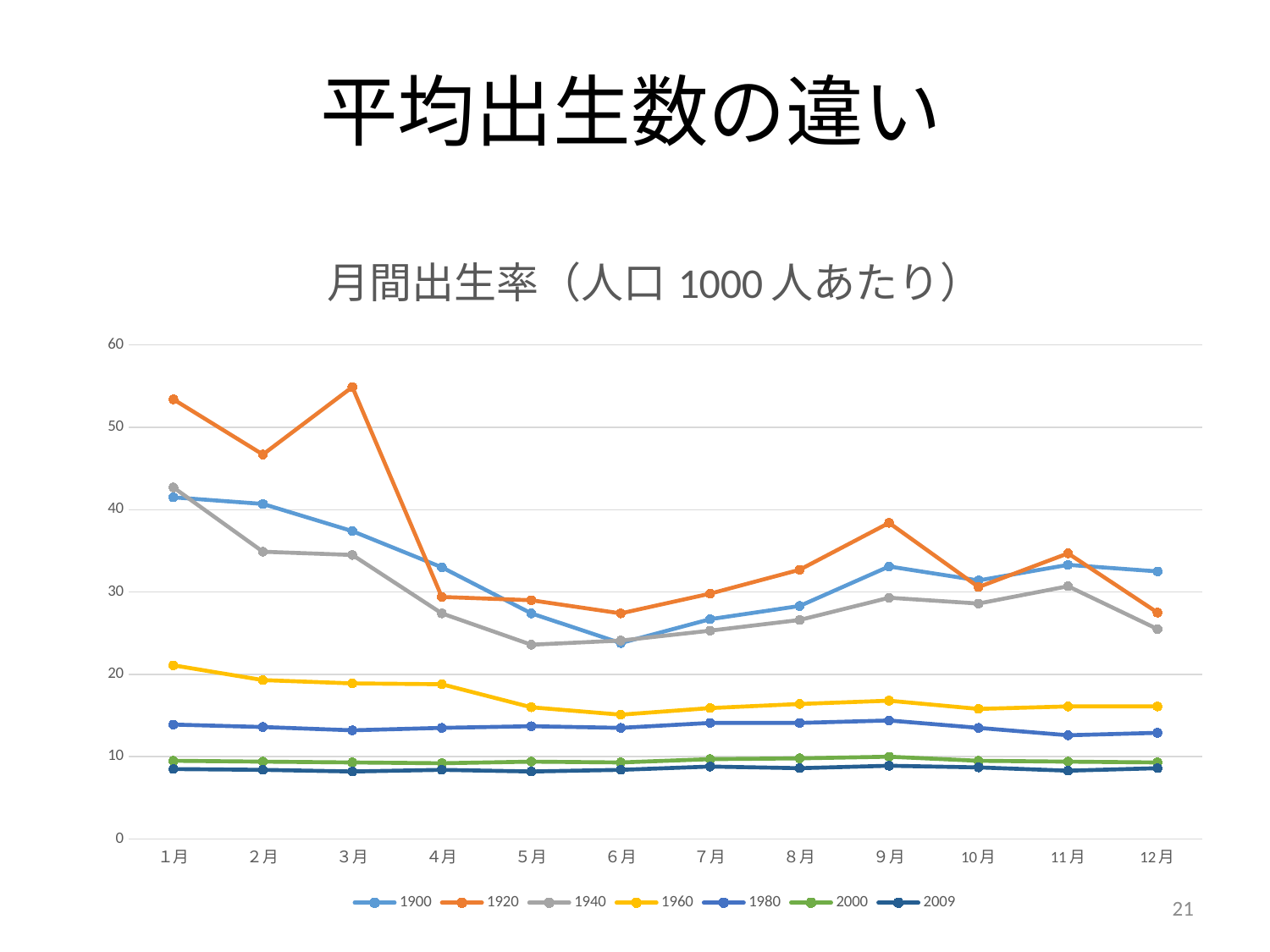
Does the 1960 series rise or fall from 1月 to 6月? fall Which series has the lowest value in 1月? 2009 In 6月, which is larger, the value for 1920 or the value for 1900? 1920 In which month does the 1920 series reach its highest value? 3月 Is the value for 1980 in 9月 greater or less than 10? greater Is the value for 1960 in 6月 greater or less than 20? less What kind of chart is shown on the slide? line chart How many series does the legend list? 7 How many months are plotted along the x axis? 12 Is the value for 1920 in 3月 greater or less than 50? greater What is the title of the chart? 月間出生率（人口 1000 人あたり） Which series has the highest value in 1月? 1920